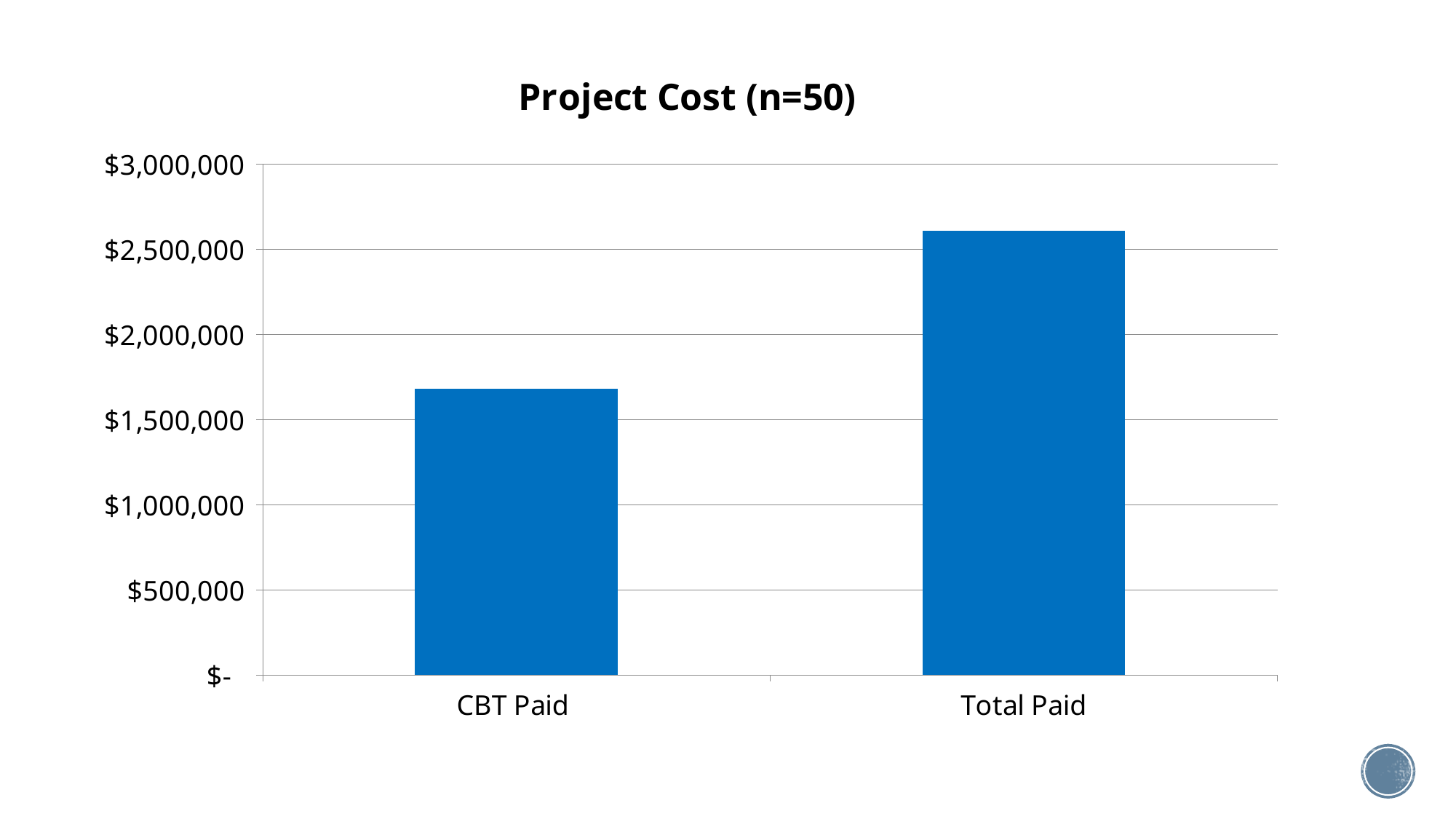
Which category has the lowest value? CBT Paid Which is larger, the value for CBT Paid or the value for Total Paid? Total Paid Is the value for Total Paid greater or less than $3,000,000? less Which category has the highest value? Total Paid How many categories are plotted in the chart? 2 What is the highest value shown on the vertical axis? $3,000,000 Do the values rise or fall from CBT Paid to Total Paid? rise Is the value for CBT Paid greater or less than $2,000,000? less Is the value for CBT Paid greater or less than $1,500,000? greater What is the title of the chart? Project Cost (n=50) What kind of chart is shown on the slide? bar chart